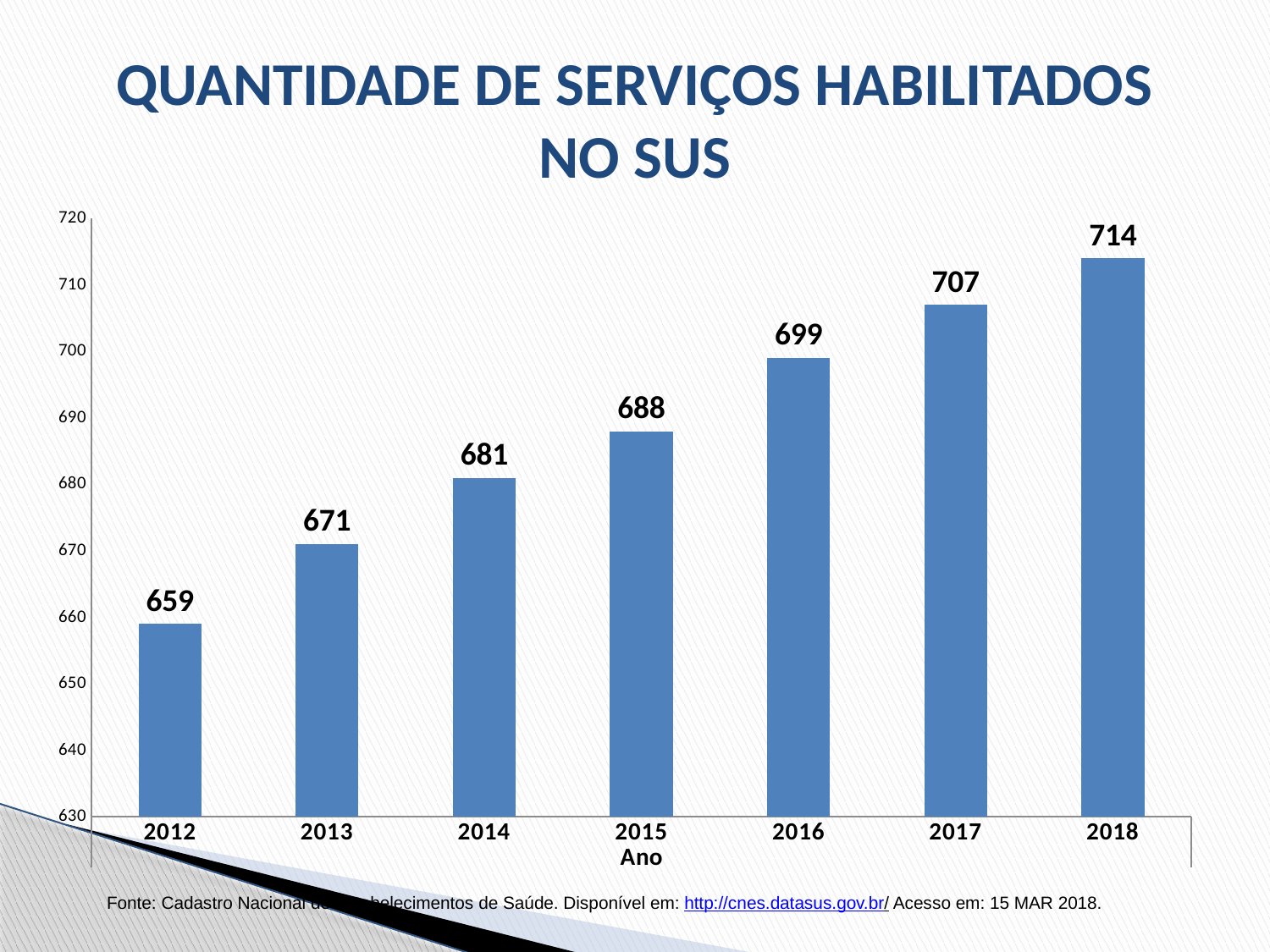
What is the value for 2018? 714 Is the value for 2016 greater or less than 690? greater Which year has the lowest value? 2012 What is the difference between the values for 2018 and 2012? 55 What kind of chart is shown on the slide? bar chart Which year has the highest value? 2018 Do the values rise or fall from 2012 to 2018? rise Which is larger, the value for 2014 or the value for 2017? 2017 What is the value for 2012? 659 What is the value for 2015? 688 What is the difference between the values for 2016 and 2015? 11 How many years are shown on the x axis? 7